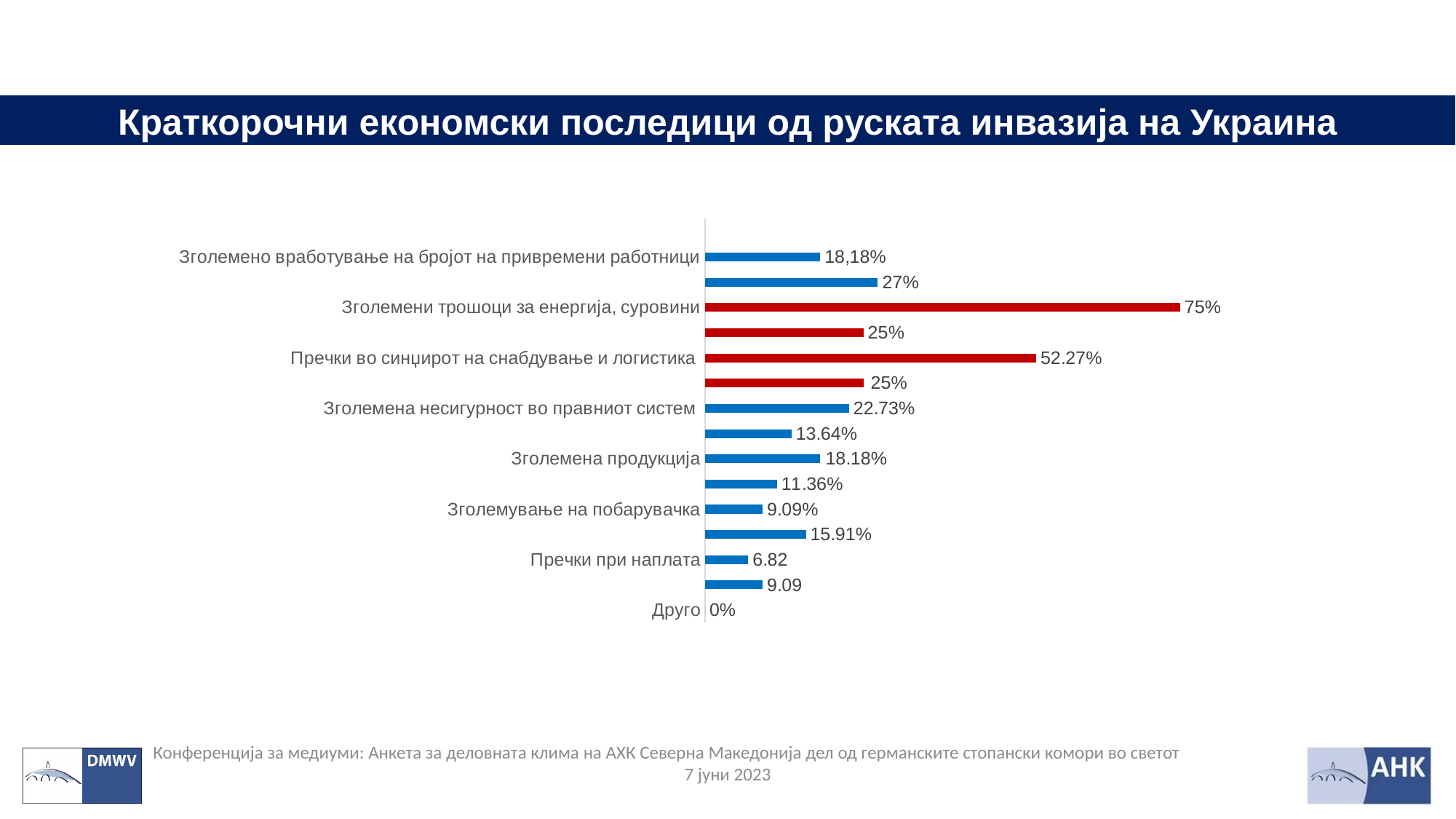
What kind of chart is shown on the slide? Bar chart Which labelled category has the highest value? Зголемени трошоци за енергија, суровини What value is shown for Пречки во синџирот на снабдување и логистика? 52.27% Which is larger: the value for Зголемена продукција or the value for Зголемување на побарувачка? Зголемена продукција What value is shown for Зголемување на побарувачка? 9.09% What value is shown for Друго? 0% What is the title of the slide? Краткорочни економски последици од руската инвазија на Украина What value is shown for Зголемена несигурност во правниот систем? 22.73% What value is shown for Зголемени трошоци за енергија, суровини? 75% What value is shown for Пречки при наплата? 6.82 What is the difference between the values for Зголемени трошоци за енергија, суровини and Пречки во синџирот на снабдување и логистика? 22.73% Which labelled category has the lowest value? Друго